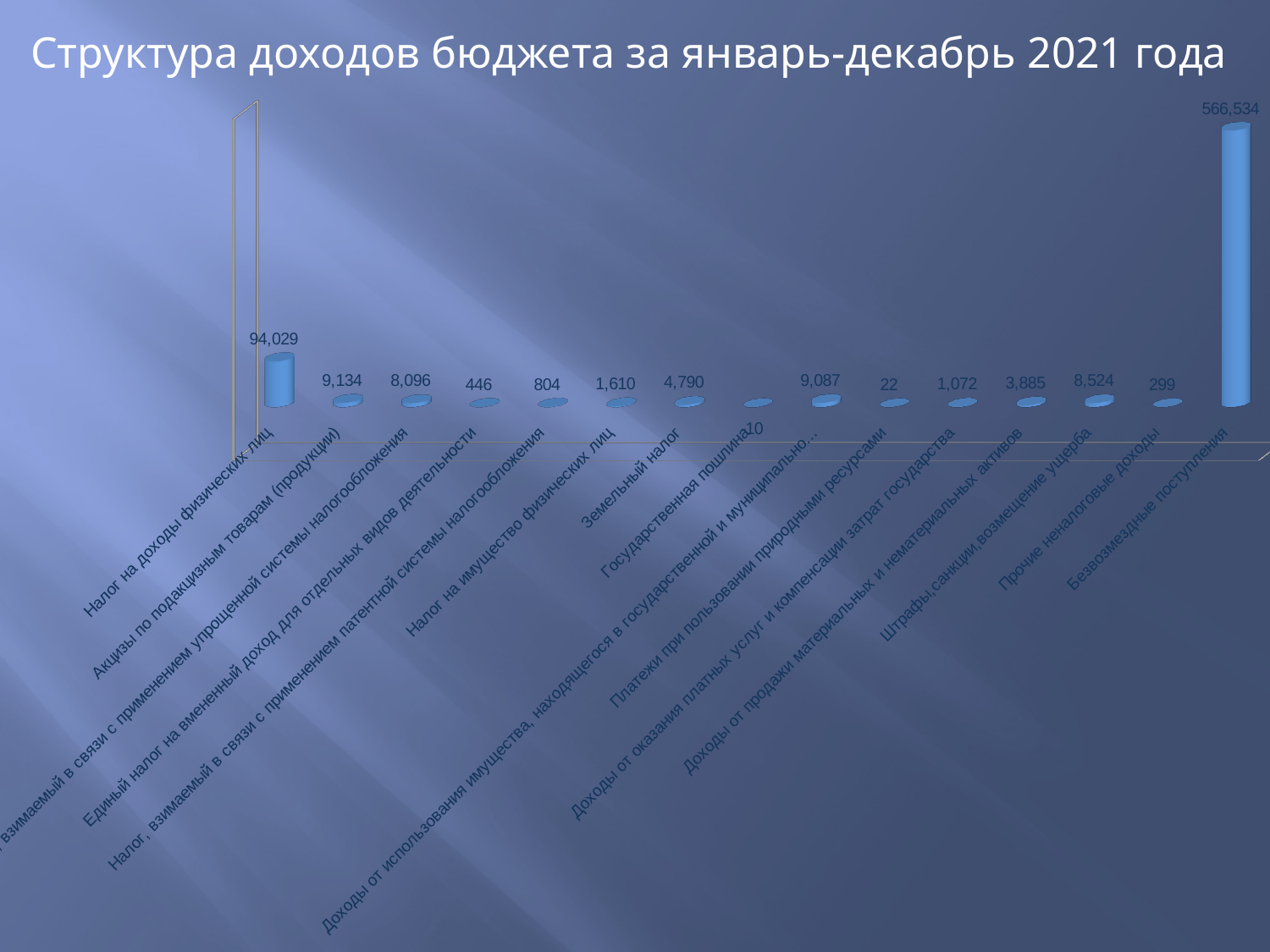
What is the difference between Акцизы по подакцизным товарам (продукции) and Налог, взимаемый в связи с применением упрощенной системы налогообложения? 1,038 Which is larger: Земельный налог or Штрафы, санкции, возмещение ущерба? Штрафы, санкции, возмещение ущерба What is the value for Безвозмездные поступления? 566,534 What is the difference between Безвозмездные поступления and Налог на доходы физических лиц? 472,505 What is the value for Земельный налог? 4,790 Which category has the lowest value? Государственная пошлина What is the value for Платежи при пользовании природными ресурсами? 22 How many categories are shown in the chart? 15 What is the value for Штрафы, санкции, возмещение ущерба? 8,524 What is the title of the chart? Структура доходов бюджета за январь-декабрь 2021 года Which category has the highest value? Безвозмездные поступления What is the value for Налог на доходы физических лиц? 94,029